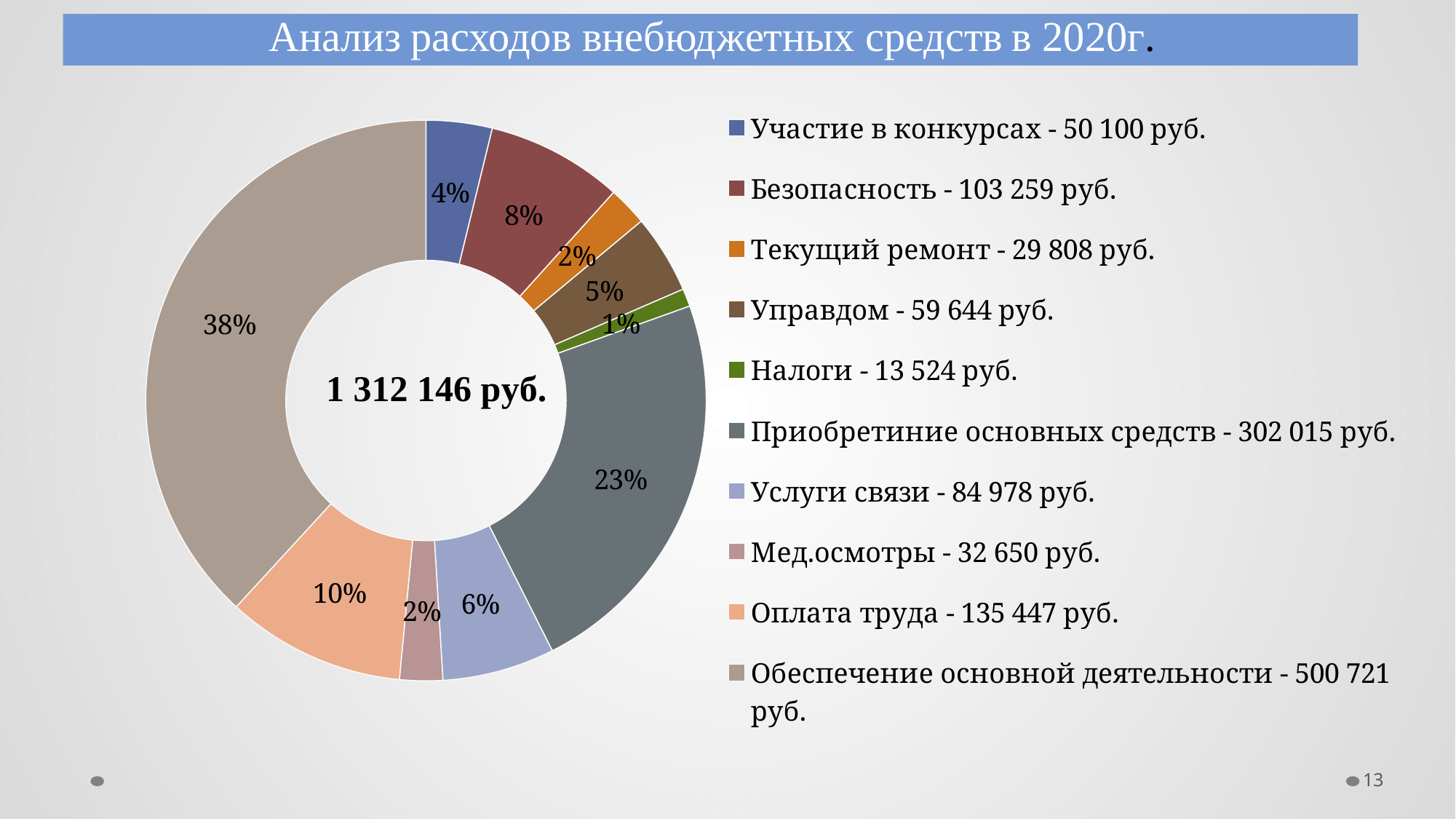
What share of the chart does Приобретиние основных средств account for? 23% What amount in rubles is listed in the legend for Безопасность? 103 259 руб. Which category has the smallest share of the chart? Налоги What kind of chart is shown on the slide? Doughnut (pie) chart Which category has the largest share of the chart? Обеспечение основной деятельности What amount in rubles is listed in the legend for Услуги связи? 84 978 руб. What share of the chart does Обеспечение основной деятельности account for? 38% What total amount is printed in the centre of the chart? 1 312 146 руб. How many categories does the chart show? 10 What is the difference in percentage points between the shares of Обеспечение основной деятельности and Приобретиние основных средств? 15% Which has a larger share, Безопасность or Услуги связи? Безопасность What percentage is shown for Оплата труда? 10%